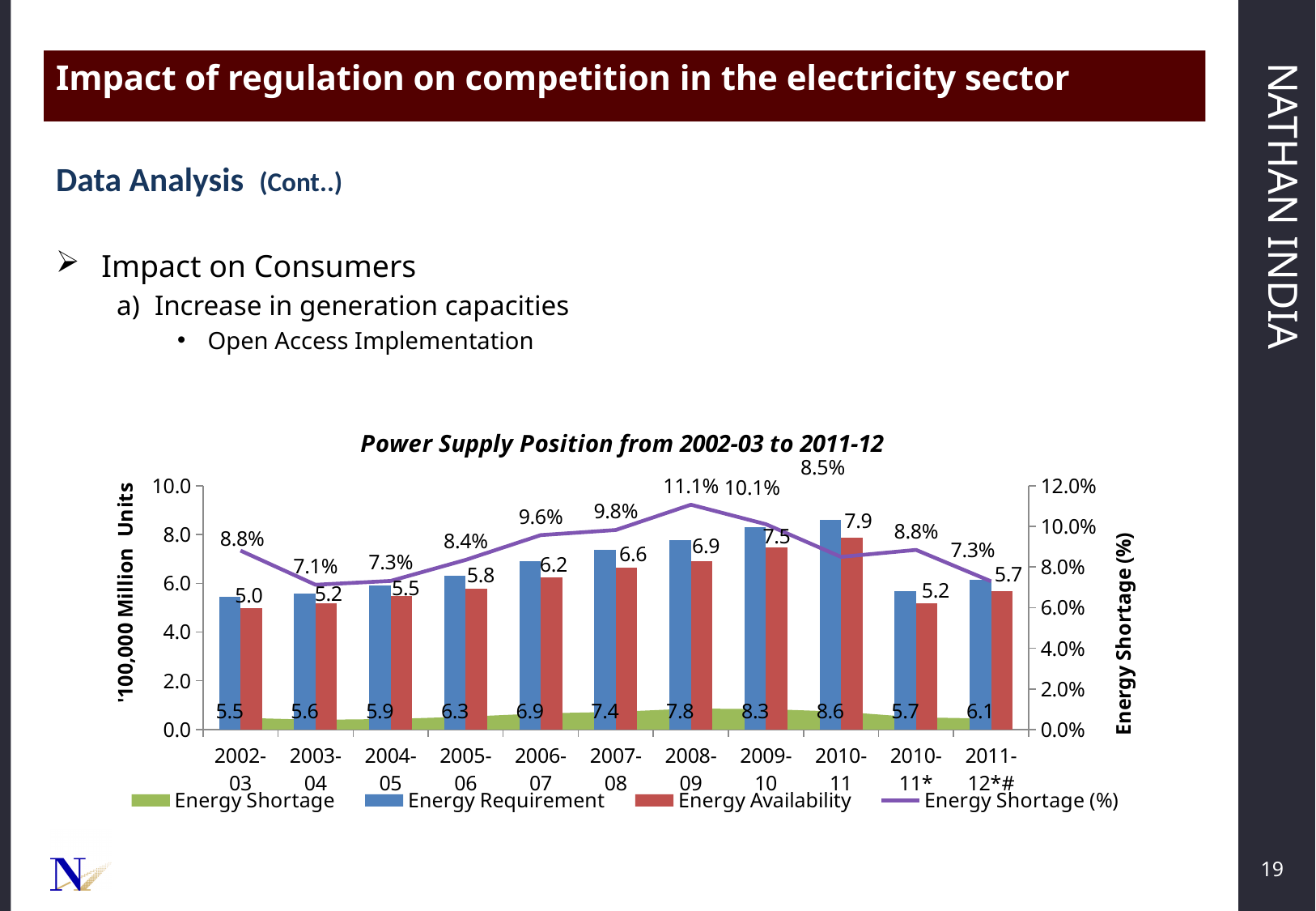
What is the Energy Availability value for 2005-06? 5.8 What is the Energy Shortage (%) value for 2006-07? 9.6% Which is larger, the Energy Availability in 2010-11 or in 2011-12*#? 2010-11 How many year categories are shown on the x axis of the chart? 11 What is the title of the chart? Power Supply Position from 2002-03 to 2011-12 How many series does the chart legend list? 4 Does the Energy Requirement rise or fall from 2002-03 to 2010-11? rise What is the difference between Energy Requirement and Energy Availability in 2009-10? 0.8 Which series is plotted as a line rather than bars? Energy Shortage (%) In which year is the Energy Shortage (%) highest? 2008-09 What is the Energy Requirement value for 2008-09? 7.8 In which year is the Energy Requirement lowest? 2002-03